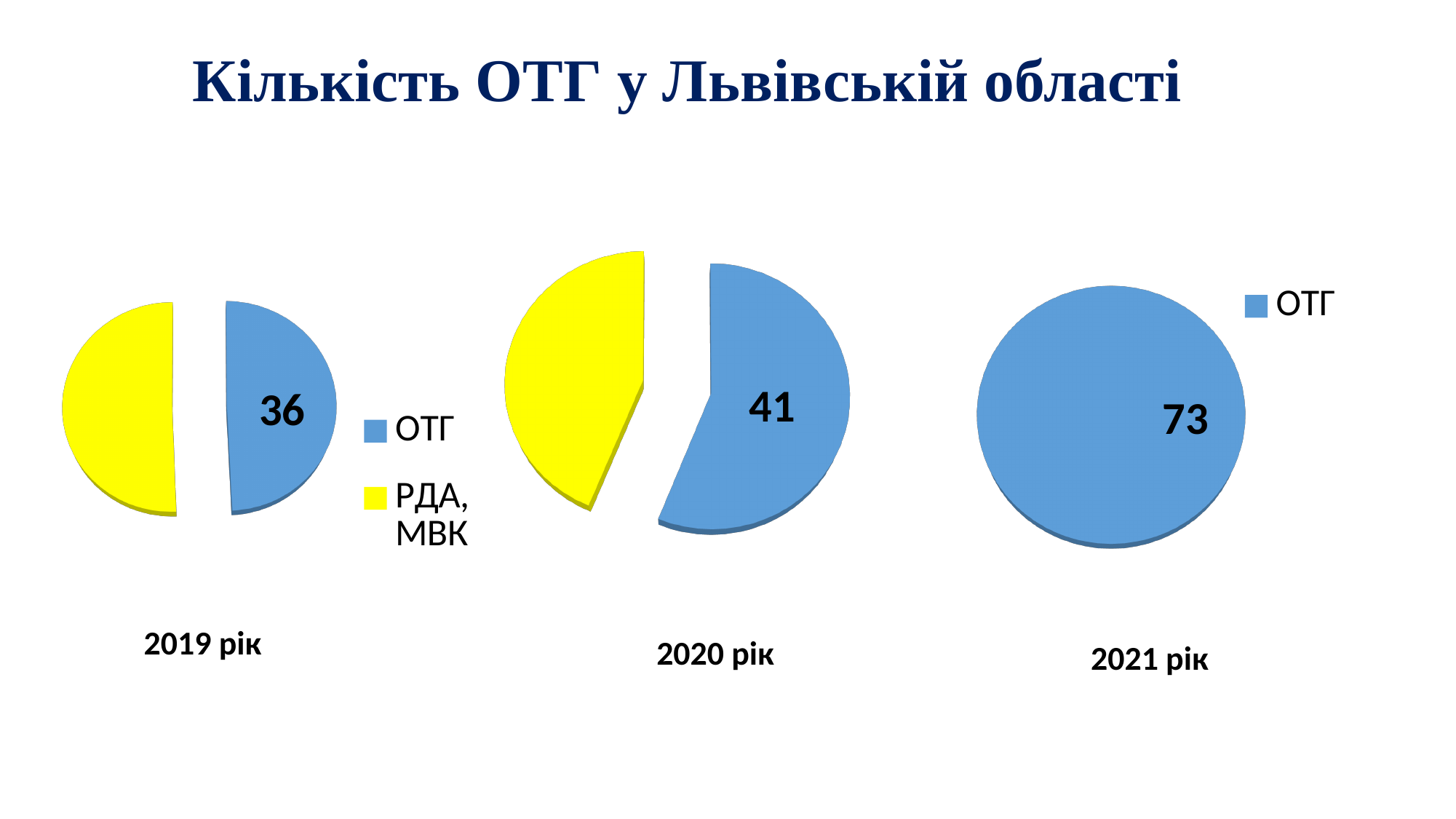
In the 2021 рік chart, what is the value shown for ОТГ? 73 In the 2019 рік chart, which colour represents ОТГ? Blue What kind of chart is used for the 2019 рік data? Pie chart Which year's chart shows the highest value for ОТГ: 2019 рік, 2020 рік or 2021 рік? 2021 рік How many entries does the legend of the 2019 рік chart list? 2 Across the 2019, 2020 and 2021 charts, do the ОТГ values rise or fall over the years? Rise How many slices does the 2021 рік pie chart have? 1 What is the difference between the ОТГ value in the 2021 рік chart and the ОТГ value in the 2019 рік chart? 37 In the 2020 рік chart, what is the value shown for ОТГ? 41 How many slices does the 2020 рік pie chart have? 2 In the 2019 рік chart, what is the value shown for ОТГ? 36 How many entries does the legend of the 2021 рік chart list? 1